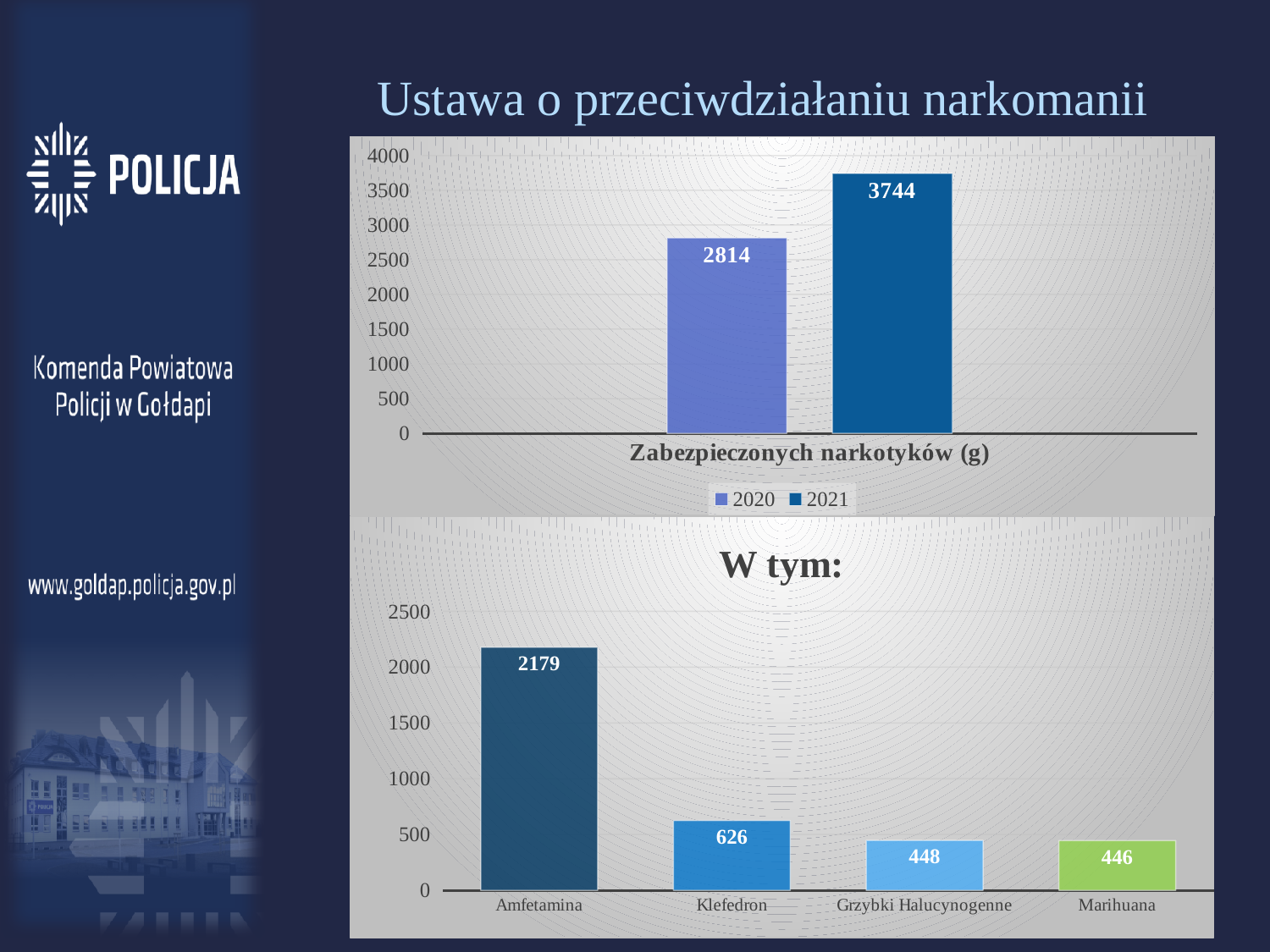
In the bottom chart (W tym:), what is the value for Grzybki Halucynogenne? 448 In the bottom chart (W tym:), what is the value for Amfetamina? 2179 In the top chart (Zabezpieczonych narkotyków (g)), what is the value for 2021? 3744 In the bottom chart (W tym:), how many categories are shown? 4 In the top chart (Zabezpieczonych narkotyków (g)), what is the difference between the 2021 and 2020 values? 930 In the bottom chart (W tym:), which category has the highest value? Amfetamina In the top chart (Zabezpieczonych narkotyków (g)), what is the value for 2020? 2814 In the bottom chart (W tym:), what is the value for Klefedron? 626 In the bottom chart (W tym:), what is the difference between the values for Amfetamina and Klefedron? 1553 In the top chart (Zabezpieczonych narkotyków (g)), how many series does the legend list? 2 In the top chart (Zabezpieczonych narkotyków (g)), which year has the higher value, 2020 or 2021? 2021 What kind of chart is the top chart (Zabezpieczonych narkotyków (g))? bar chart